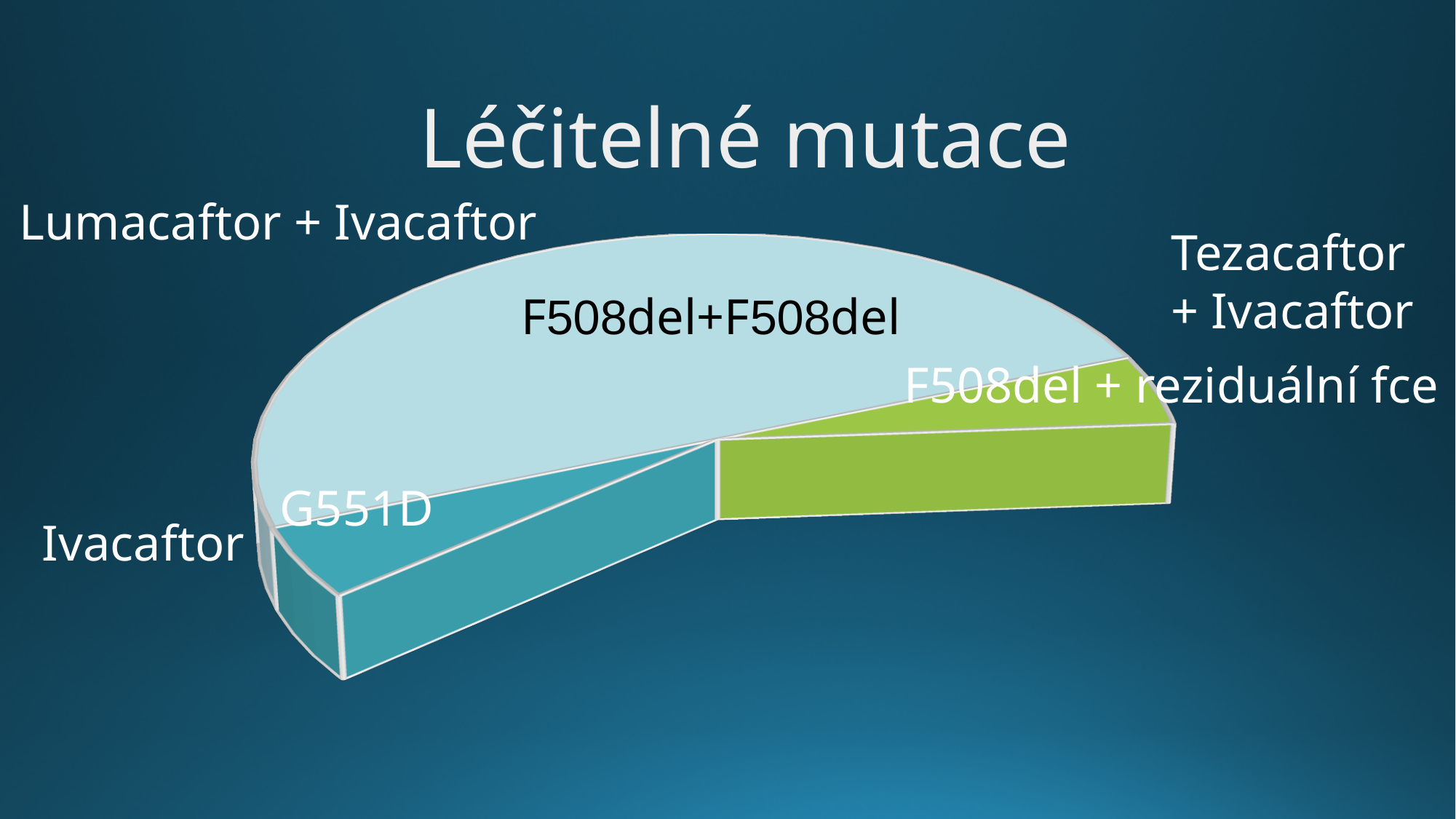
What kind of chart is shown on the slide? pie chart Which slice is larger, F508del+F508del or F508del + reziduální fce? F508del+F508del What is the title of the chart on the slide? Léčitelné mutace Which slice of the pie chart is the largest? F508del+F508del Which slice is larger, F508del+F508del or G551D? F508del+F508del Which slice is larger, F508del + reziduální fce or G551D? F508del + reziduální fce Which drug label is placed next to the F508del+F508del slice? Lumacaftor + Ivacaftor